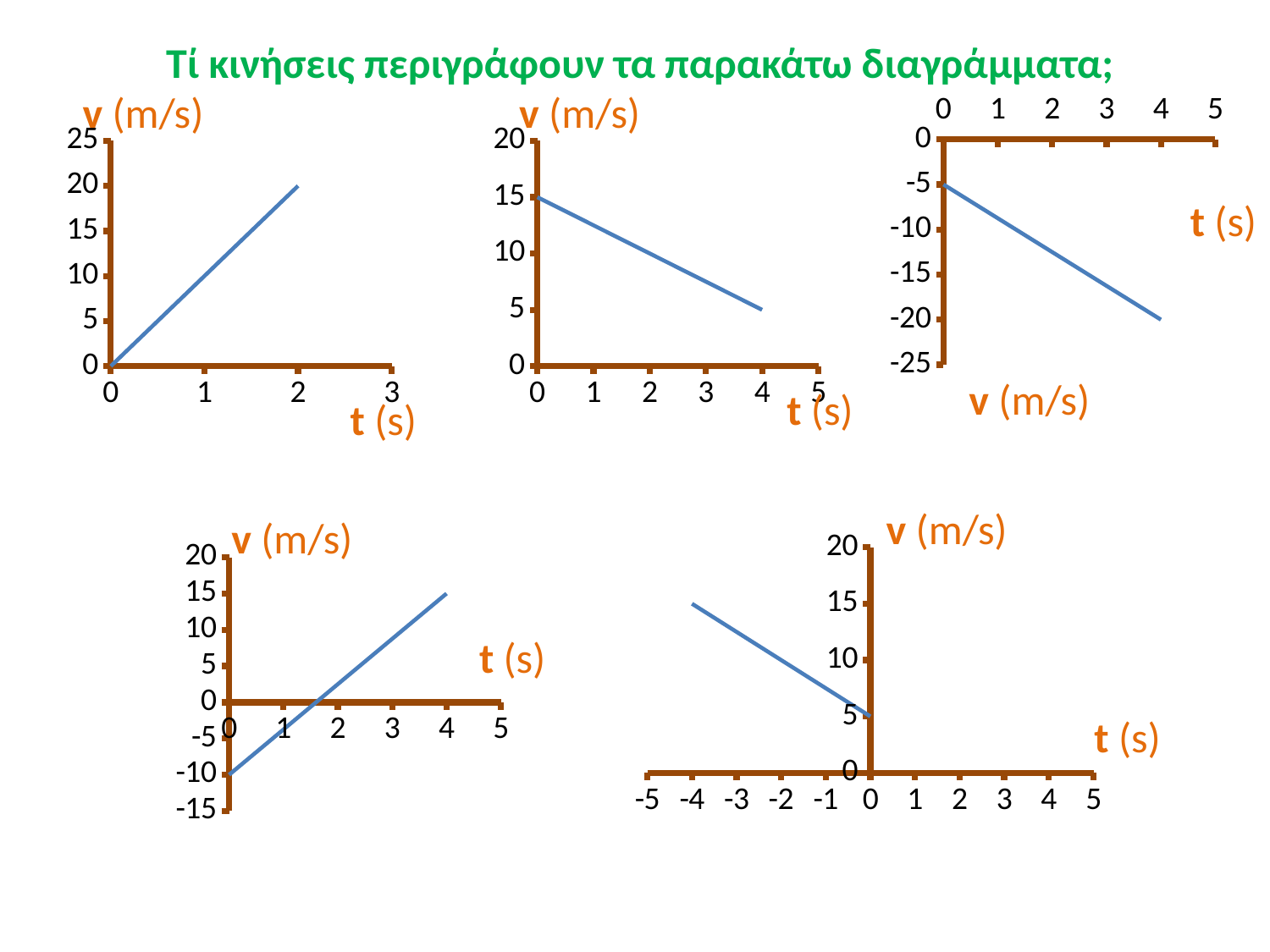
In the top-left chart, what is the value of v at t = 2 s? 20 In the bottom-right chart, what is the value of v at t = -4 s? 15 In the bottom-left chart, does v rise or fall as t increases? rise What kind of chart is the top-left chart? line chart In the top-middle chart, what is the value of v at t = 4 s? 5 In the bottom-left chart, what is the value of v at t = 0 s? -10 How many charts are shown on the slide? 5 In the top-right chart, is the value of v at t = 2 s greater or less than -5? less In the top-middle chart, does v rise or fall as t increases? fall In the top-right chart, what is the value of v at t = 4 s? -20 In the top-middle chart, what is the value of v at t = 0 s? 15 In the top-left chart, does the velocity v rise or fall as t increases? rise